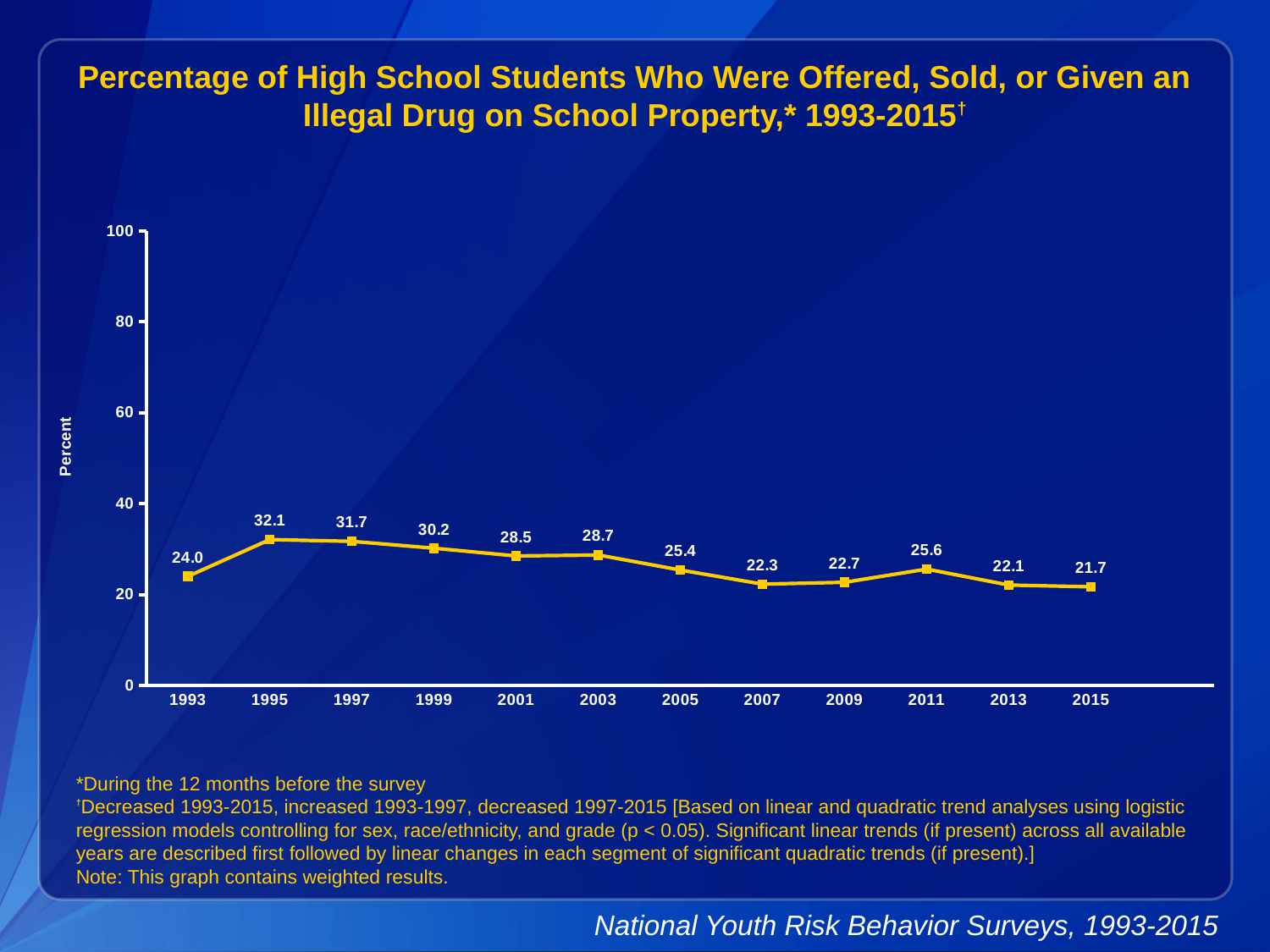
What kind of chart is shown? line chart Which year has the lowest value? 2015 How many years are plotted on the x axis? 12 Is the value for 1995 greater or less than 40? less What is the value for 2015? 21.7 What is the value for 1993? 24.0 Which year has the highest value? 1995 What is the difference between the values for 1995 and 2015? 10.4 What is the label on the y axis? Percent Do the values generally rise or fall from 1997 to 2015? fall Which is larger, the value for 1997 or the value for 2007? 1997 What is the value for 2011? 25.6